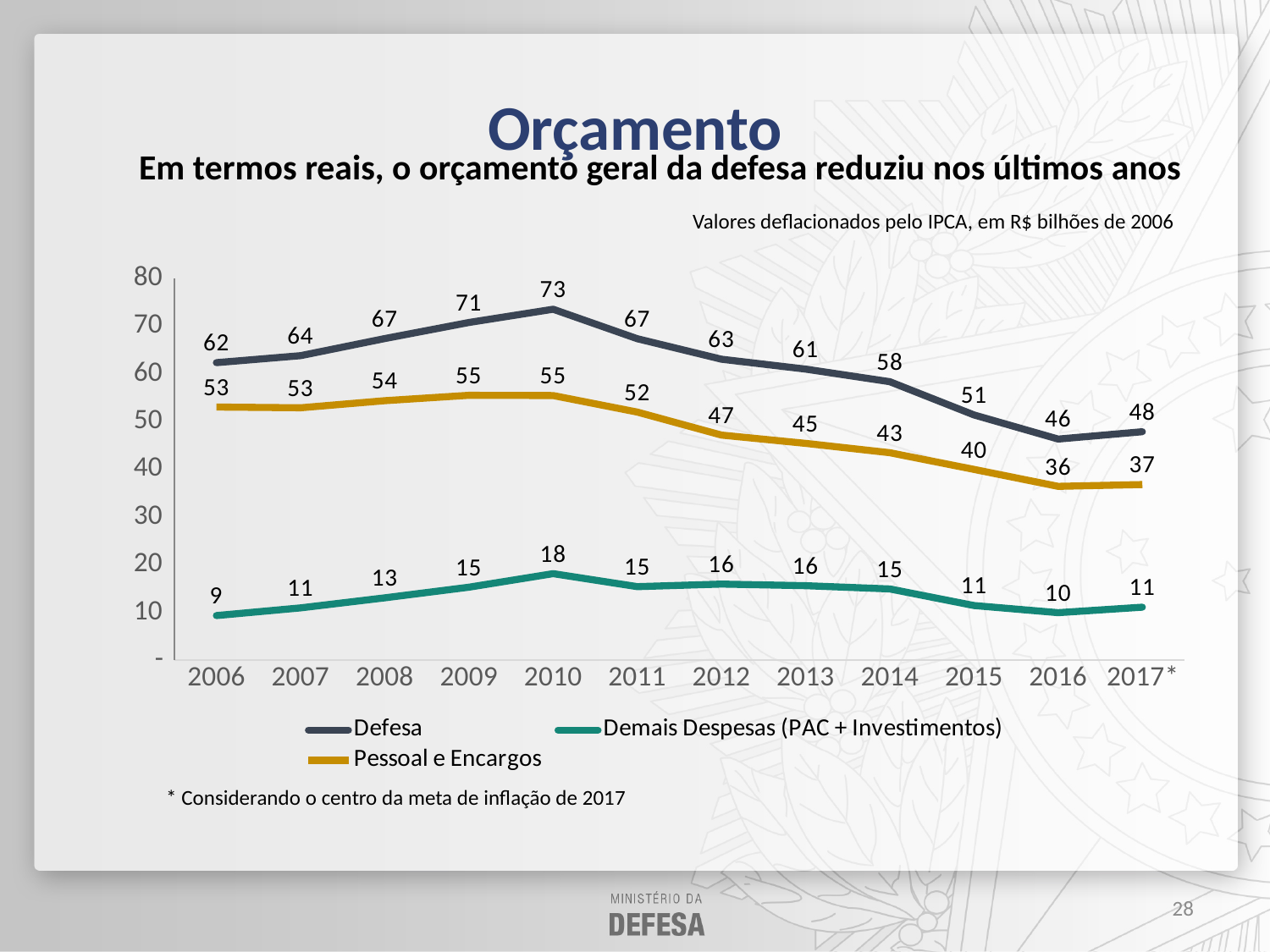
Which is larger: Pessoal e Encargos in 2009 or Pessoal e Encargos in 2014? Pessoal e Encargos in 2009 In which year is the Demais Despesas (PAC + Investimentos) series lowest? 2006 In which year does the Defesa series reach its highest value? 2010 How many years are shown on the x axis? 12 What is the title of the chart on the slide? Orçamento What is the value for Pessoal e Encargos in 2016? 36 What is the difference between the Defesa value in 2010 and in 2016? 27 What is the value for Demais Despesas (PAC + Investimentos) in 2006? 9 What is the value for Defesa in 2010? 73 How many series does the legend list? 3 What kind of chart is shown on the slide? Line chart Does the Defesa series rise or fall from 2010 to 2016? Fall